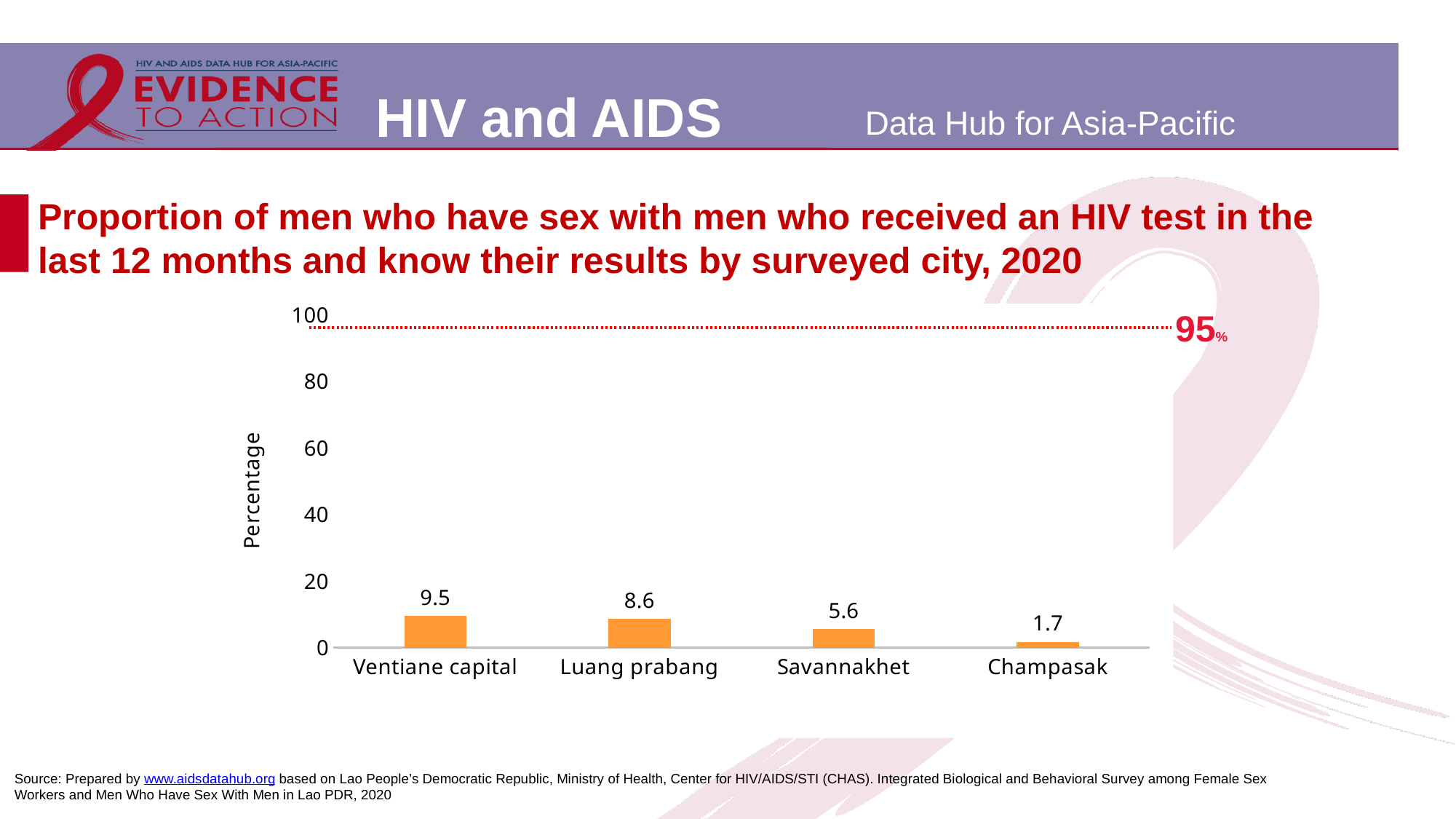
What target value is marked by the dotted red line? 95% What is the value for Champasak? 1.7 What is the value for Luang prabang? 8.6 What is the difference between the values for Luang prabang and Savannakhet? 3.0 What is the value for Ventiane capital? 9.5 Which city has the lowest value? Champasak How many cities are shown on the chart? 4 What is the difference between the values for Ventiane capital and Champasak? 7.8 What kind of chart is this? Bar chart What is the value for Savannakhet? 5.6 Which city has the highest value? Ventiane capital Which is larger, the value for Savannakhet or the value for Luang prabang? Luang prabang